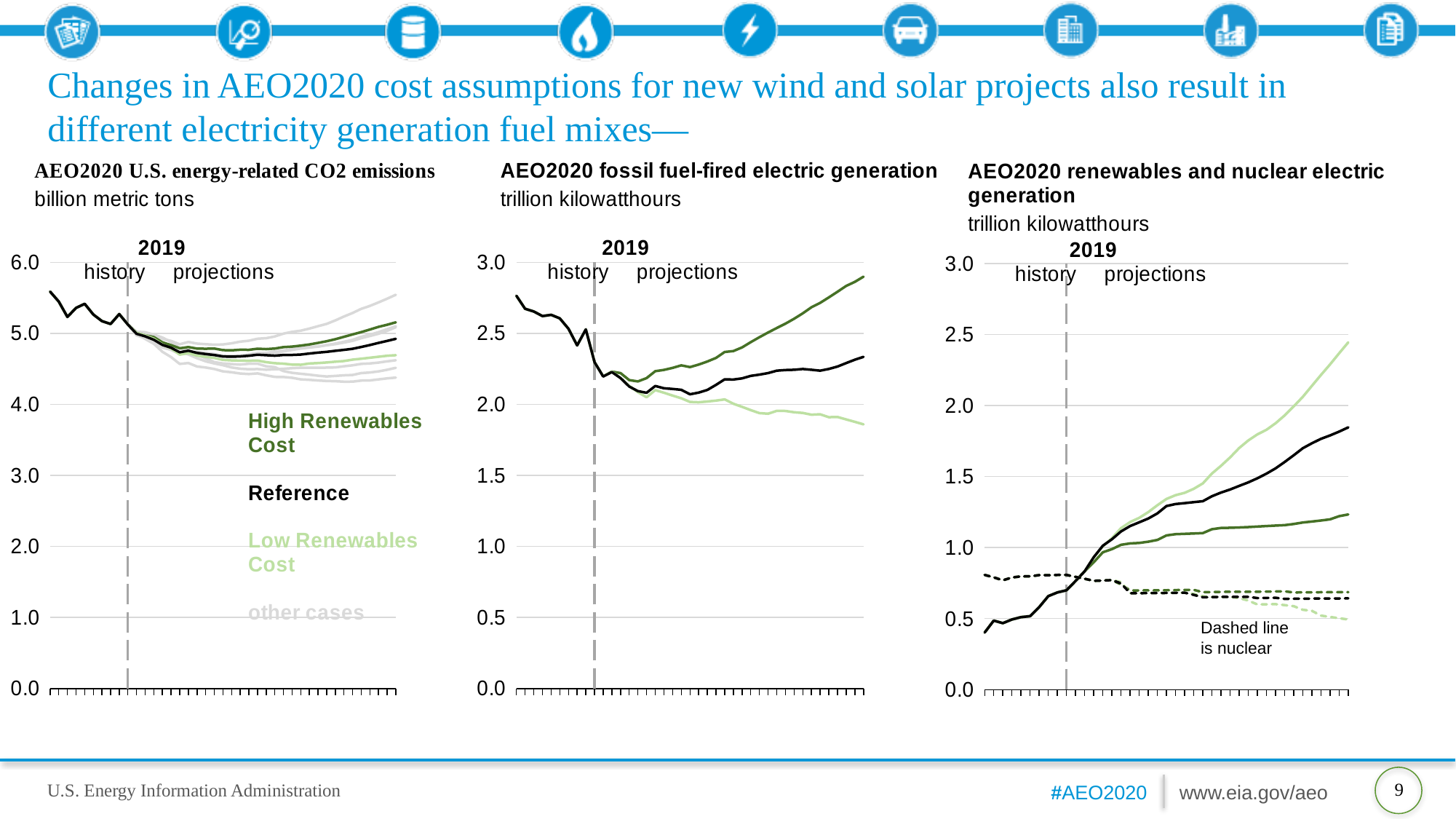
What kind of chart is the AEO2020 U.S. energy-related CO2 emissions chart? line chart In the AEO2020 renewables and nuclear electric generation chart, does the Low Renewables Cost line rise or fall over the projection period? rise In the AEO2020 fossil fuel-fired electric generation chart, does the Low Renewables Cost line rise or fall over the projection period? fall How many labelled entries does the legend of the AEO2020 U.S. energy-related CO2 emissions chart list? 4 What year marks the boundary between history and projections in the three charts? 2019 In the AEO2020 U.S. energy-related CO2 emissions chart, is the High Renewables Cost line at the end of the projection period greater or less than 5.0? greater In the AEO2020 renewables and nuclear electric generation chart, is the Reference line at the end of the projection period greater or less than 1.5? greater In the AEO2020 fossil fuel-fired electric generation chart, which is higher at the end of the projection period, the Reference line or the Low Renewables Cost line? Reference In the AEO2020 fossil fuel-fired electric generation chart, is the Low Renewables Cost line at the end of the projection period greater or less than 2.0? less In the AEO2020 renewables and nuclear electric generation chart, what do the dashed lines represent? nuclear In the AEO2020 renewables and nuclear electric generation chart, which is higher at the end of the projection period, the Low Renewables Cost line or the High Renewables Cost line? Low Renewables Cost